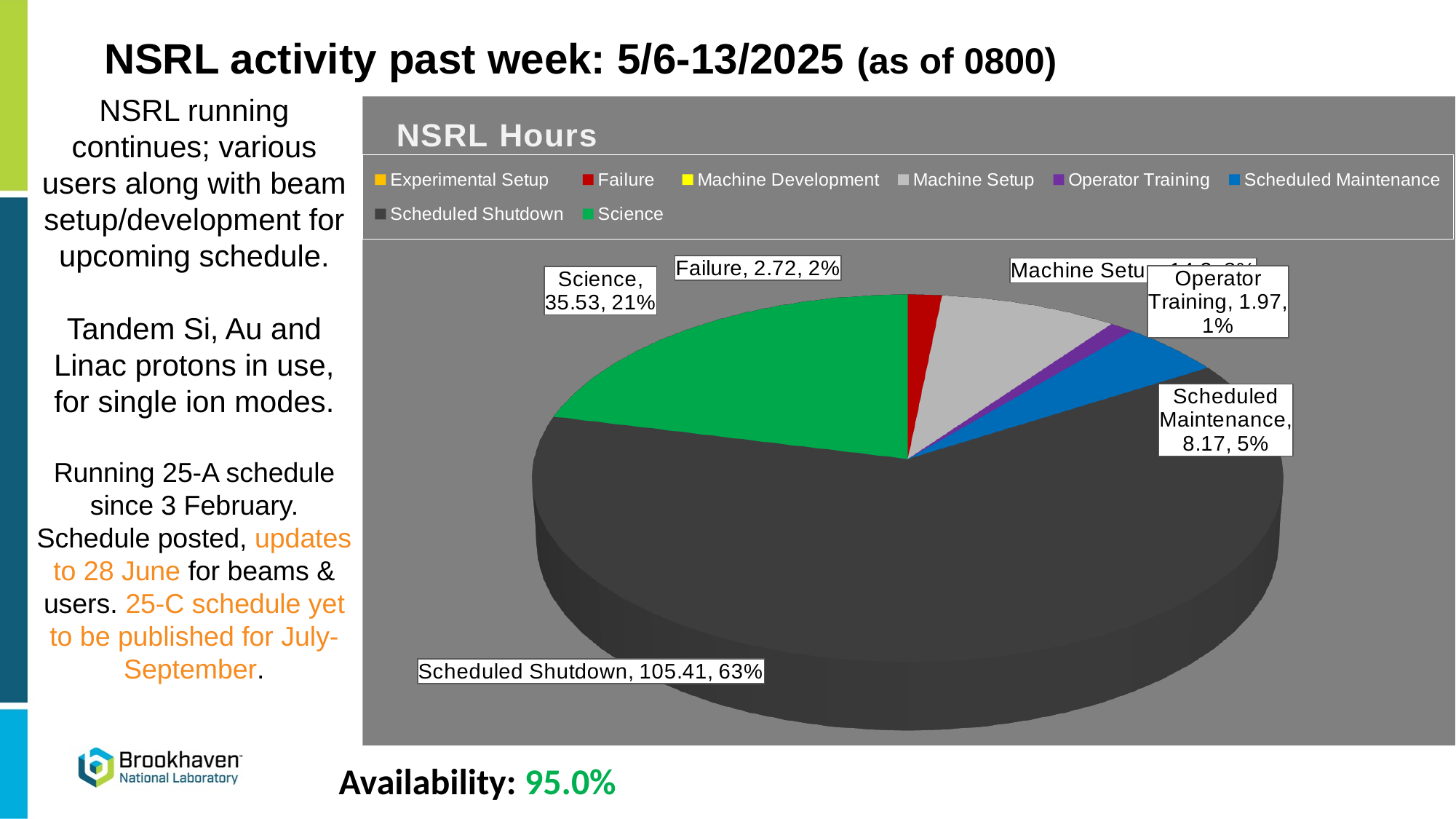
Which is larger, Science or Scheduled Maintenance? Science What is the value for Scheduled Maintenance? 8.17 What is the value for Scheduled Shutdown? 105.41 What is the value for Science? 35.53 What share of the pie does Operator Training represent? 1% How many entries does the chart legend list? 8 What is the value for Failure? 2.72 What is the title of the chart? NSRL Hours Which category has the largest slice of the pie? Scheduled Shutdown What type of chart is shown on the slide? pie chart What share of the pie does Scheduled Shutdown represent? 63% What is the difference between the Scheduled Shutdown value and the Science value? 69.88